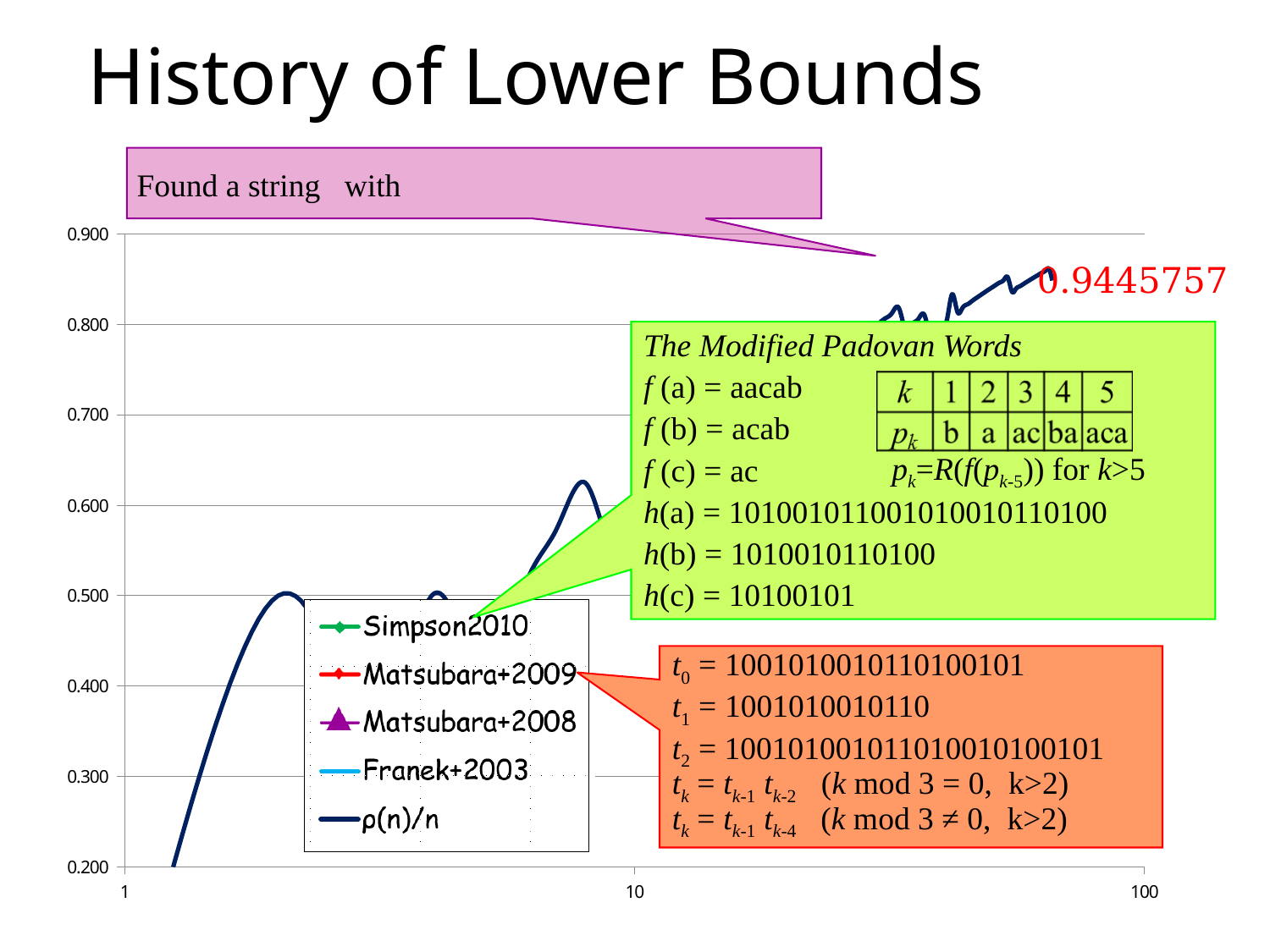
Which series is listed first in the chart legend? Simpson2010 Is the value of the ρ(n)/n curve near the right end of the chart (around x = 100) greater or less than 0.800? greater Is the value of the ρ(n)/n curve at its first peak (between x = 1 and x = 10) greater or less than 0.600? less What is the highest tick value shown on the y axis of the chart? 0.900 What is the lowest tick value shown on the y axis of the chart? 0.200 What kind of chart is shown on the slide? line chart How many series does the chart legend list? 5 What value is printed in red next to the top right end of the curve? 0.9445757 What is the largest tick value shown on the x axis of the chart? 100 Which series is listed last in the chart legend? ρ(n)/n Does the ρ(n)/n curve overall rise or fall as x increases from 1 to 100? rise